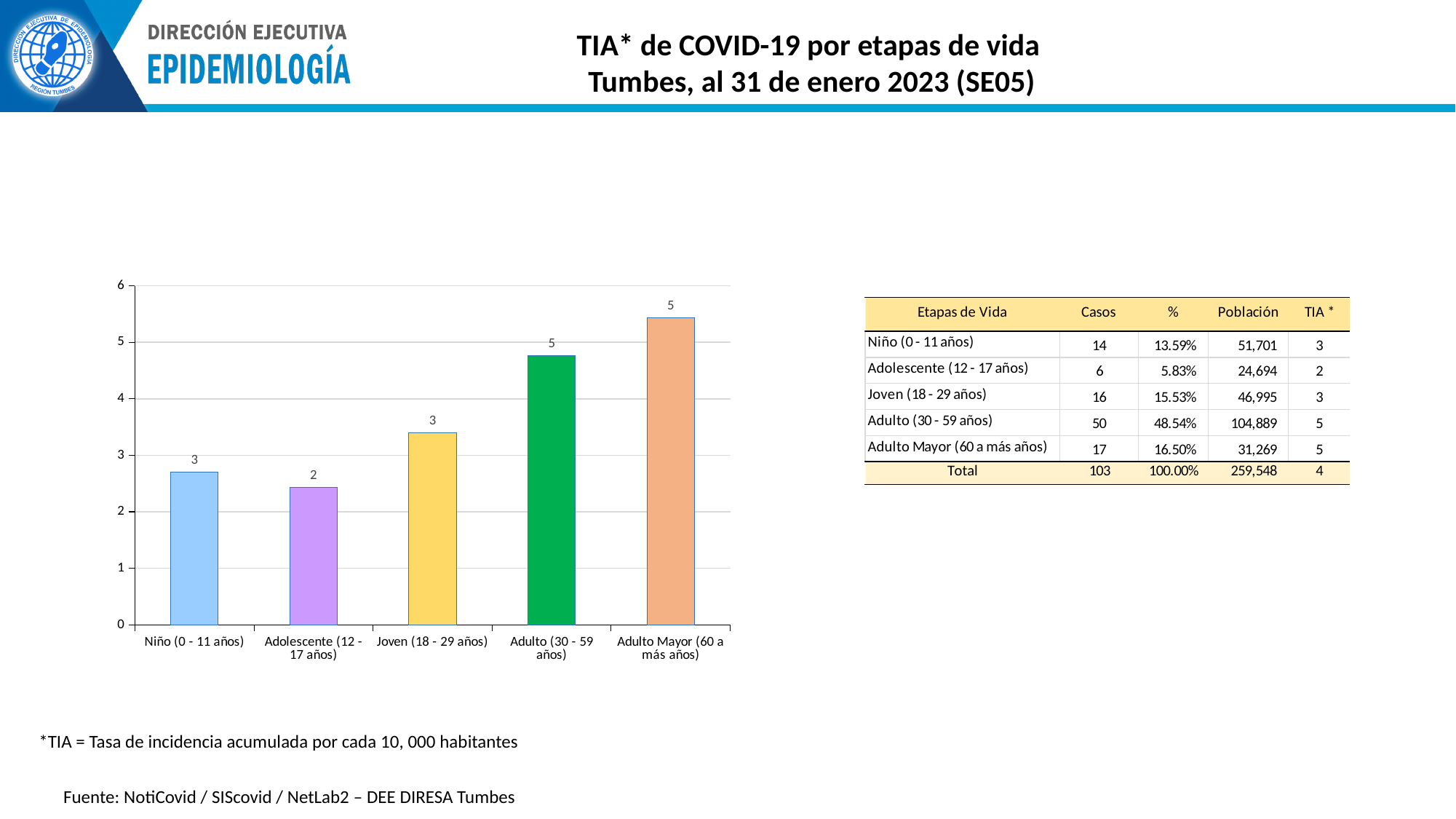
Which life stage has the shortest bar in the chart? Adolescente (12 - 17 años) What kind of chart is used to show the TIA by life stage? bar chart Is the value for Adulto (30 - 59 años) greater or less than 4? greater How many life-stage categories are shown on the x axis of the bar chart? 5 What is the data label shown for Adolescente (12 - 17 años) in the bar chart? 2 What is the data label shown for Adulto (30 - 59 años) in the bar chart? 5 Which life stage has the tallest bar in the chart? Adulto Mayor (60 a más años) Is the value for Adolescente (12 - 17 años) greater or less than 3? less What colour is the bar for Adulto (30 - 59 años)? green Is the bar for Adulto (30 - 59 años) taller or shorter than the bar for Joven (18 - 29 años)? taller What is the data label shown for Joven (18 - 29 años) in the bar chart? 3